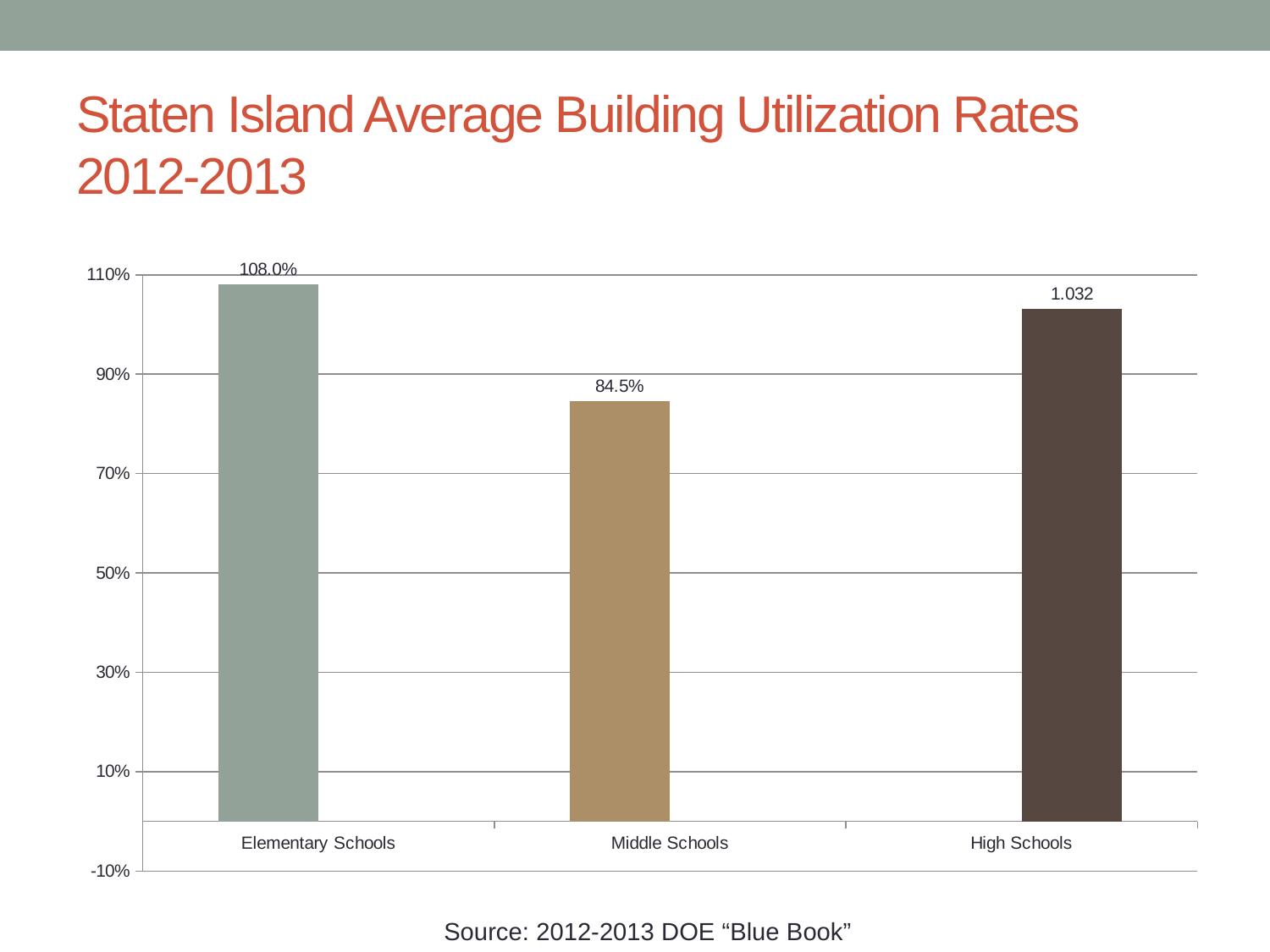
Is the value for Middle Schools greater or less than 90%? less What kind of chart is shown on the slide? bar chart What data label is printed above the High Schools bar? 1.032 How many school types are shown on the chart? 3 Which is larger, the value for Elementary Schools or the value for Middle Schools? Elementary Schools What is the value shown for Elementary Schools? 108.0% What source is cited below the chart? 2012-2013 DOE "Blue Book" What is the value shown for Middle Schools? 84.5% Is the value for High Schools greater or less than 90%? greater Which school type has the lowest average building utilization rate? Middle Schools Which school type has the highest average building utilization rate? Elementary Schools What is the difference between the Elementary Schools value and the Middle Schools value? 23.5%